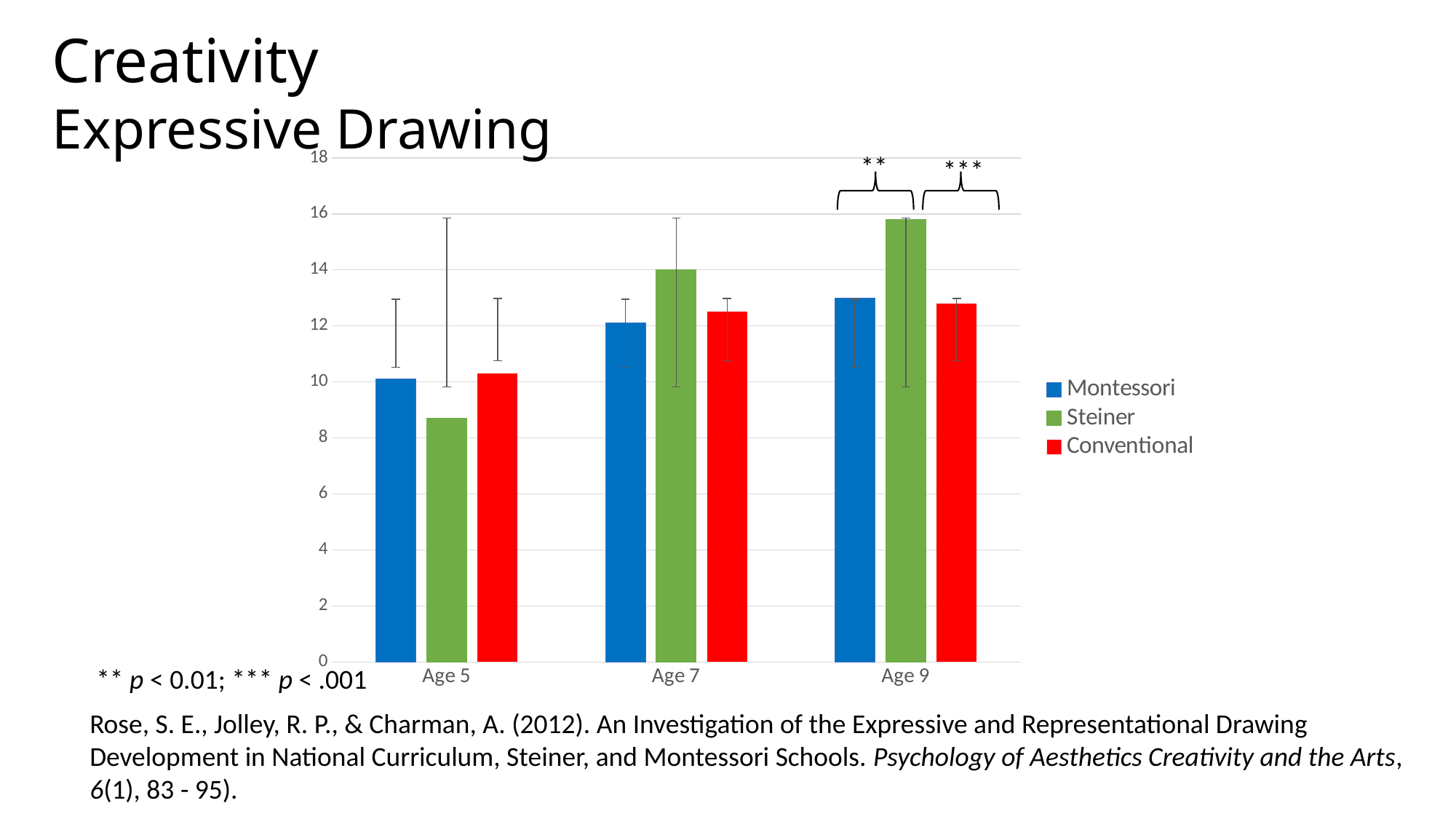
Is the value for Steiner at Age 9 greater or less than 14? greater Do the Montessori values rise or fall from Age 5 to Age 9? rise At Age 7, which is larger: the Steiner bar or the Montessori bar? Steiner How many series does the legend list? 3 How many age groups are shown on the x axis? 3 Is the value for Steiner at Age 5 greater or less than 10? less What colour represents Steiner in the legend? green Which school type has the highest bar at Age 9? Steiner What kind of chart is shown on the slide? bar chart Is the value for Conventional at Age 9 greater or less than 14? less At Age 5, which is larger: the Steiner bar or the Conventional bar? Conventional Which school type has the lowest bar at Age 5? Steiner